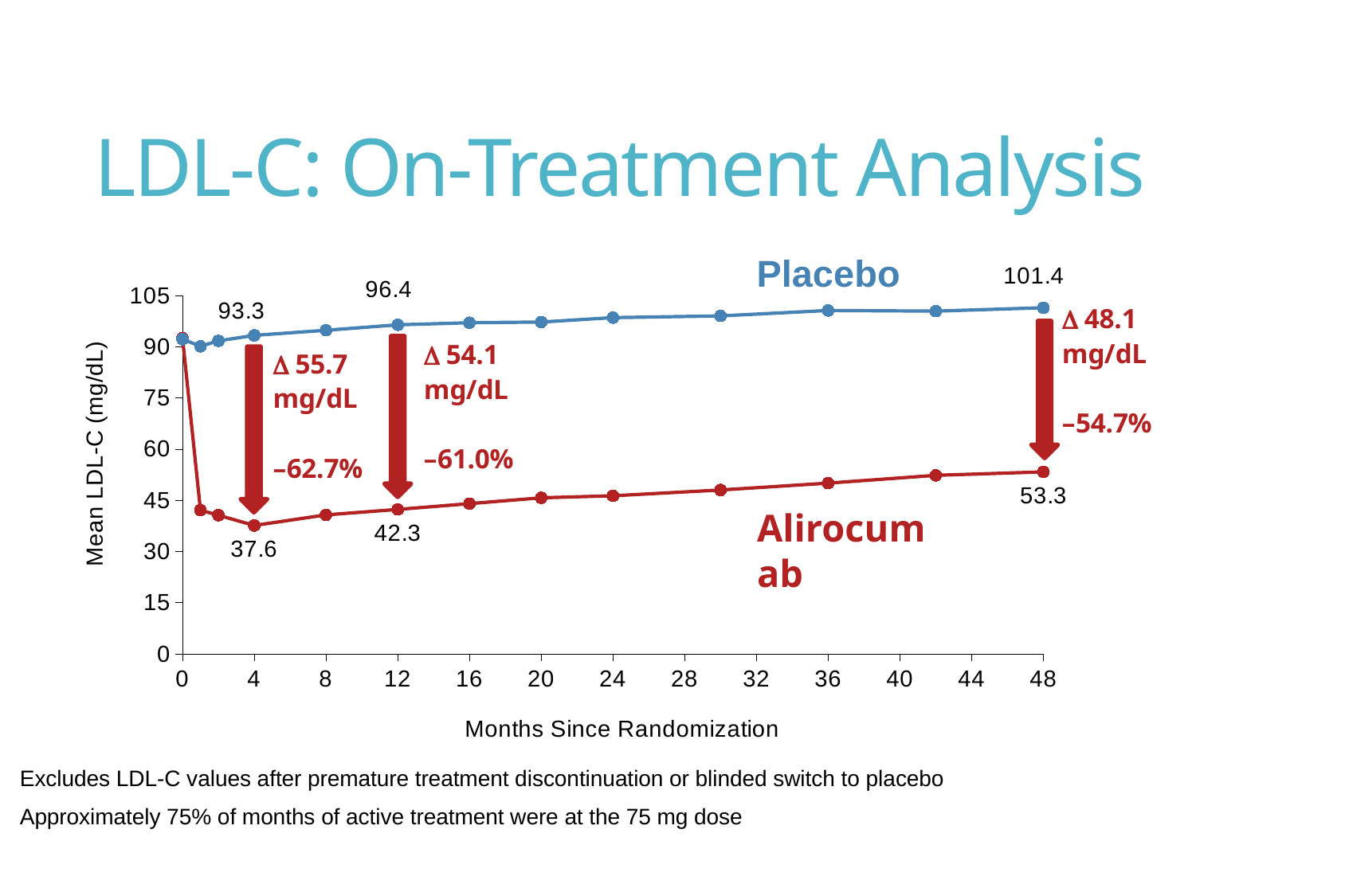
What is the difference between the Placebo and Alirocumab mean LDL-C at month 48? 48.1 mg/dL What is the mean LDL-C for Placebo at month 4? 93.3 Is the Alirocumab value at month 36 greater or less than 60? less What is the mean LDL-C for Placebo at month 48? 101.4 What type of chart is shown on the slide? line chart Which series has the higher mean LDL-C at month 12, Placebo or Alirocumab? Placebo What is the mean LDL-C for Placebo at month 12? 96.4 What is the mean LDL-C for Alirocumab at month 4? 37.6 What is the mean LDL-C for Alirocumab at month 12? 42.3 What is the percentage reduction in LDL-C for Alirocumab versus Placebo at month 4? –62.7% What is the mean LDL-C for Alirocumab at month 48? 53.3 Does the Alirocumab line rise or fall between month 4 and month 48? rise